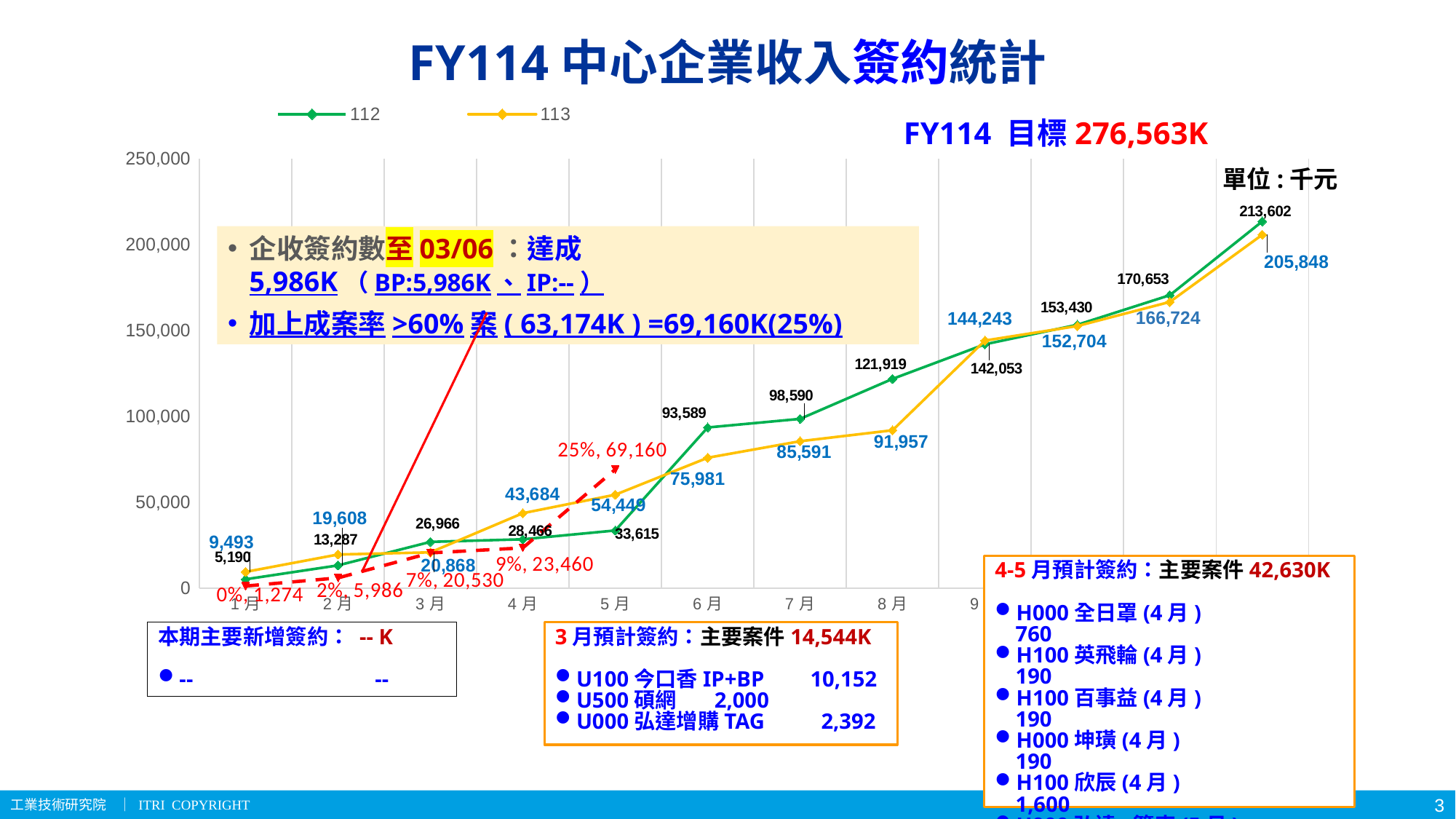
Does the 112 series rise or fall from 1月 to 8月? Rise What are the two series names shown in the legend? 112 and 113 What is the value of the 112 series at 1月? 5,190 What is the difference between the 113 and 112 values at 2月? 6,321 How many series does the legend list? 2 What is the value of the 113 series at 8月? 91,957 At 3月, which series has the larger value, 112 or 113? 112 What is the difference between the 112 and 113 values at 8月? 29,962 What kind of chart is shown on the slide? Line chart What is the value of the 112 series at 6月? 93,589 Is the value of the 113 series at 5月 greater or less than 50,000? greater What is the value of the 113 series at 4月? 43,684